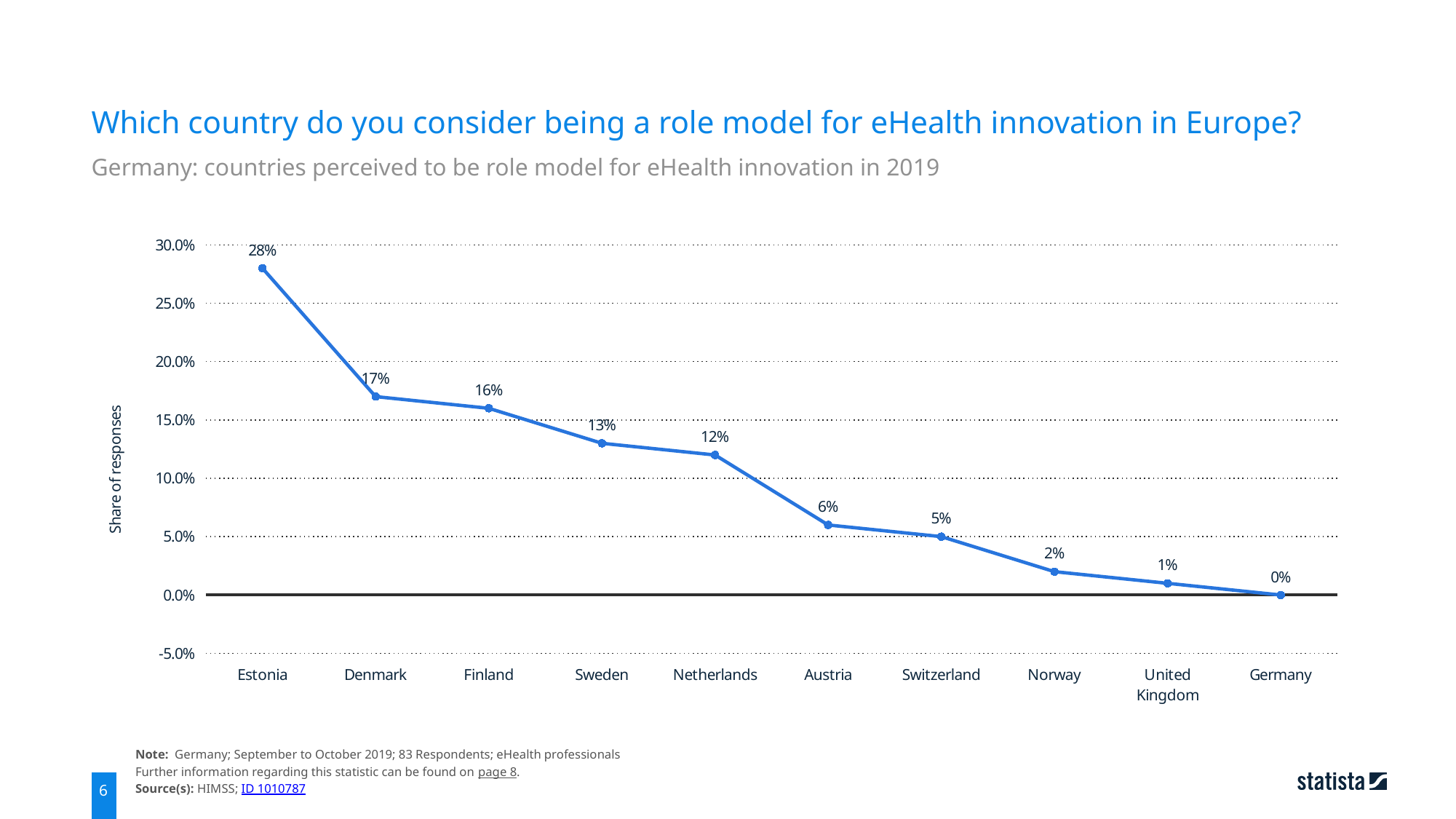
What share of responses named Estonia as a role model for eHealth innovation? 28% Do the values rise or fall from Estonia to Germany along the x axis? Fall Which country has the highest share of responses? Estonia What kind of chart is shown on the slide? Line chart What is the difference between the values for Estonia and Denmark? 11% What share of responses does Switzerland have? 5% How many countries are plotted on the chart? 10 What is the difference between the values for Netherlands and Austria? 6% Which country has the lowest share of responses? Germany Which has a larger share of responses, Sweden or Norway? Sweden What is the value for Finland? 16% Is the value for Denmark greater or less than 15.0%? greater